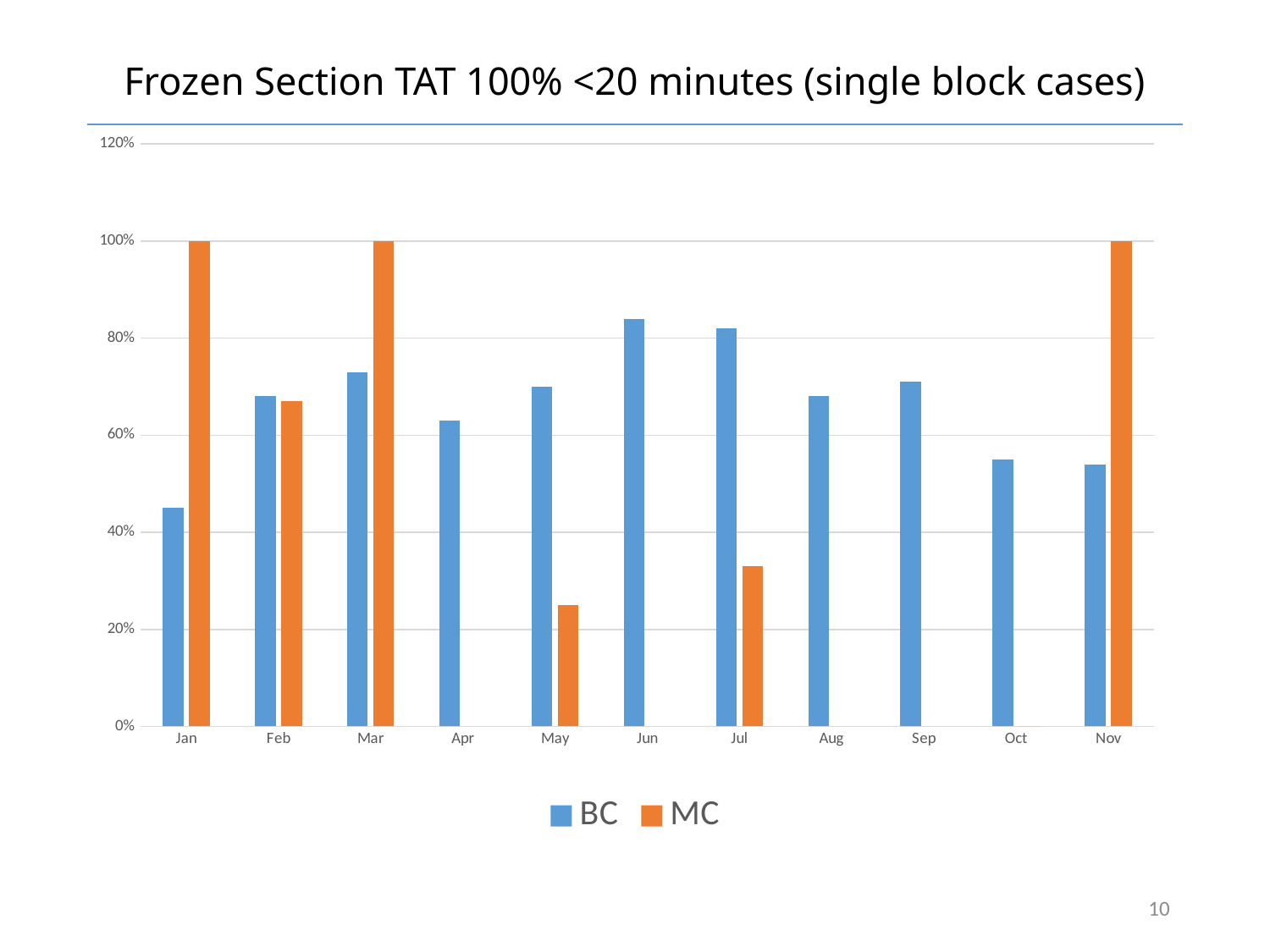
Is the BC value for Oct greater or less than 60%? less Is the BC value for Jun greater or less than 80%? greater Which month has the lowest MC value among the months with an MC bar? May In Jan, which is larger, the BC value or the MC value? MC What type of chart is shown on the slide? bar chart What is the MC value for Nov? 100% Is the MC value for Jul greater or less than 40%? less How many series does the legend list? 2 How many months are shown on the x axis? 11 What is the MC value for Jan? 100% Which month has the lowest BC value? Jan What is the title of the chart? Frozen Section TAT 100% <20 minutes (single block cases)